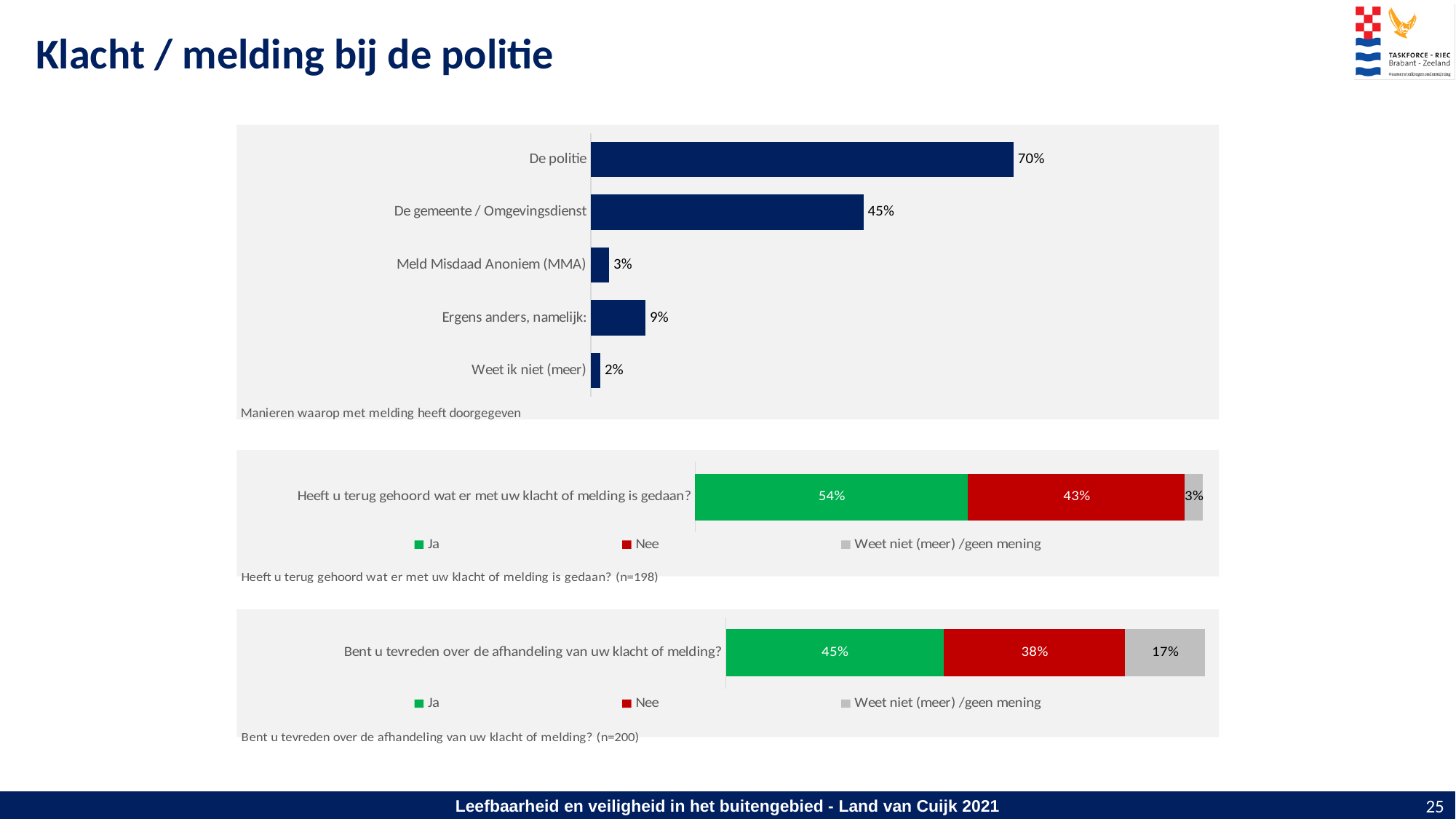
In the top chart (Manieren waarop met melding heeft doorgegeven), what is the value for Meld Misdaad Anoniem (MMA)? 3% What kind of chart is the top chart (Manieren waarop met melding heeft doorgegeven)? Bar chart In the top chart (Manieren waarop met melding heeft doorgegeven), what is the value for De politie? 70% In the bottom chart (Bent u tevreden over de afhandeling van uw klacht of melding?), what is the value for Weet niet (meer) /geen mening? 17% In the bottom chart (Bent u tevreden over de afhandeling van uw klacht of melding?), which is larger, Ja or Nee? Ja In the top chart (Manieren waarop met melding heeft doorgegeven), which category has the lowest value? Weet ik niet (meer) In the bottom chart (Bent u tevreden over de afhandeling van uw klacht of melding?), what colour is the Nee segment? Red In the middle chart (Heeft u terug gehoord wat er met uw klacht of melding is gedaan?), how many series does the legend list? 3 In the top chart (Manieren waarop met melding heeft doorgegeven), how many categories are shown? 5 In the middle chart (Heeft u terug gehoord wat er met uw klacht of melding is gedaan?), what is the value for Ja? 54% In the top chart (Manieren waarop met melding heeft doorgegeven), which category has the highest value? De politie In the top chart (Manieren waarop met melding heeft doorgegeven), what is the difference between De politie and De gemeente / Omgevingsdienst? 25%